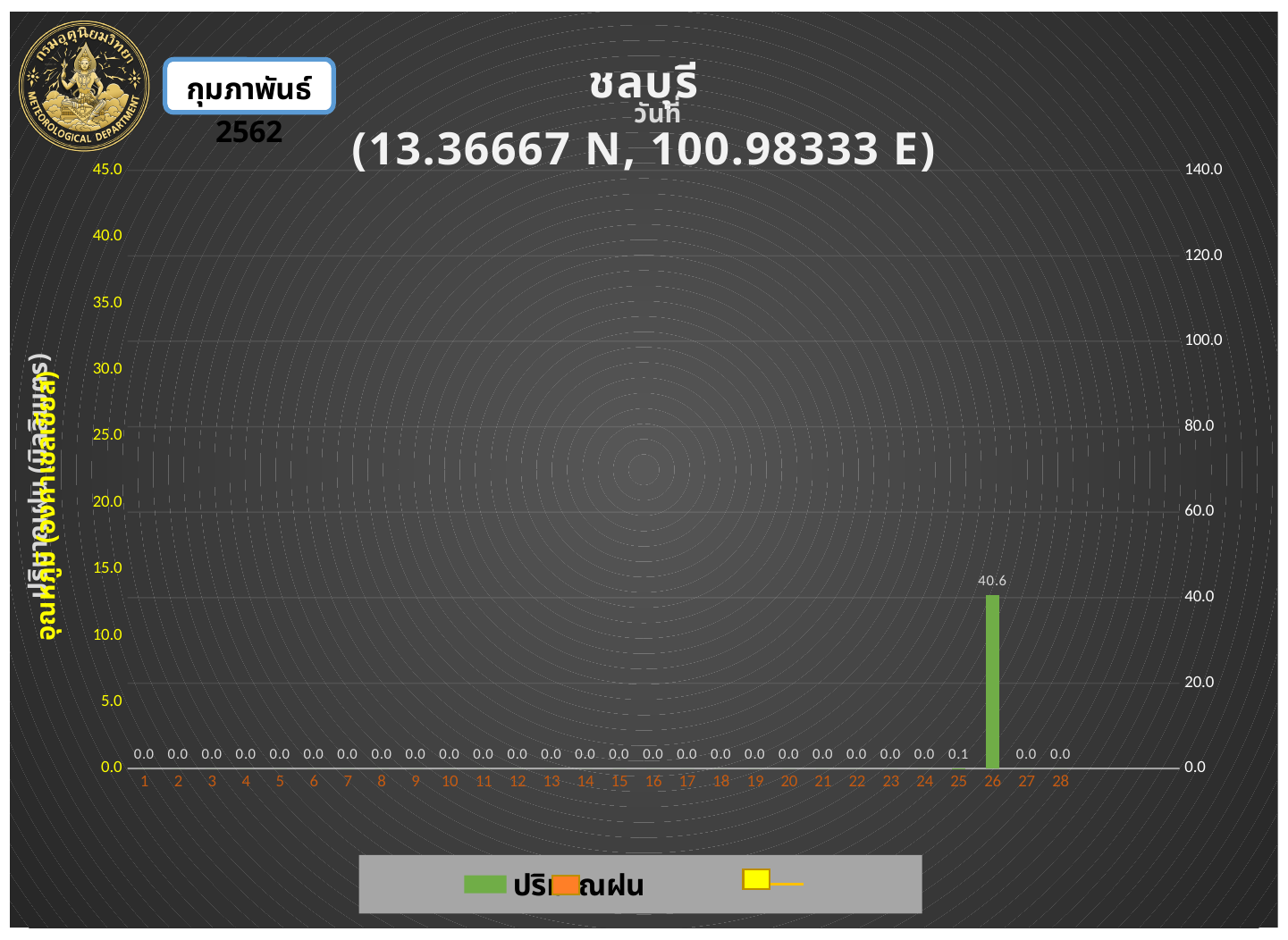
How many days are shown on the x axis? 28 What colour is the bar for day 26? green What is the rainfall value shown for day 28? 0.0 What is the rainfall value shown for day 10? 0.0 Which day has the highest rainfall value? 26 What kind of chart is used to show the rainfall values? bar chart What is the rainfall value shown for day 26? 40.6 What is the highest tick value on the right-hand axis? 140.0 What is the rainfall value shown for day 25? 0.1 Which is larger, the rainfall value for day 26 or for day 27? day 26 What is the difference between the rainfall values for day 26 and day 25? 40.5 Is the rainfall value for day 26 greater or less than 20.0 on the right-hand axis? greater